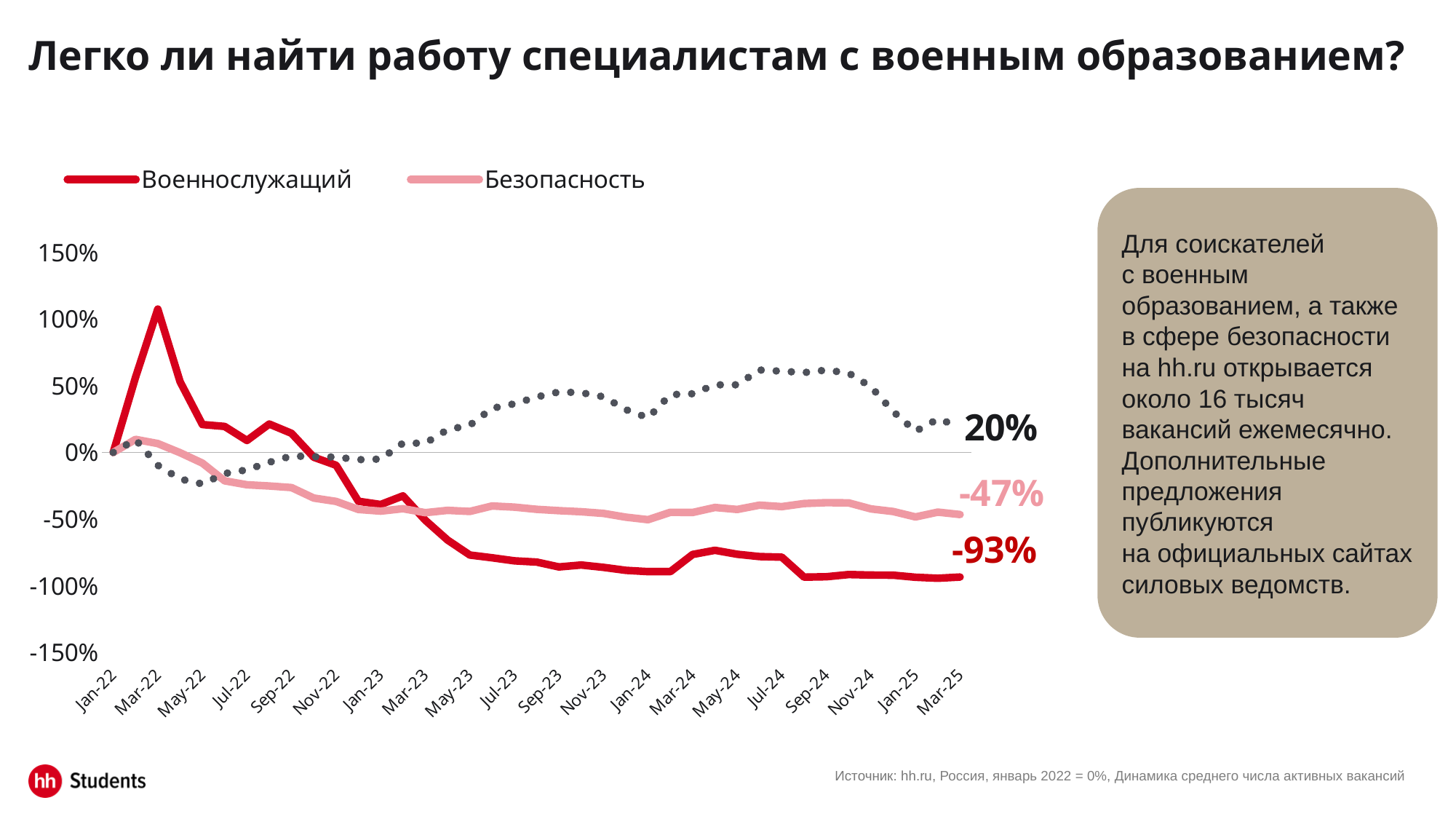
What kind of chart is shown on the slide? line chart Is the value for Военнослужащий at Jan-24 greater or less than -50%? less Is the value for Военнослужащий at Mar-22 greater or less than 50%? greater How many series does the legend list? 2 At Mar-25, which is higher: Военнослужащий or Безопасность? Безопасность What value is labelled at the end of the dotted grey line? 20% What is the difference between the end values of Безопасность (-47%) and Военнослужащий (-93%)? 46 percentage points What is the value labelled at the end of the Военнослужащий line (Mar-25)? -93% What is the value labelled at the end of the Безопасность line (Mar-25)? -47% What colour is the Военнослужащий line? red Does the Военнослужащий line rise or fall from Mar-22 to Mar-25? falls What is the title of the slide? Легко ли найти работу специалистам с военным образованием?